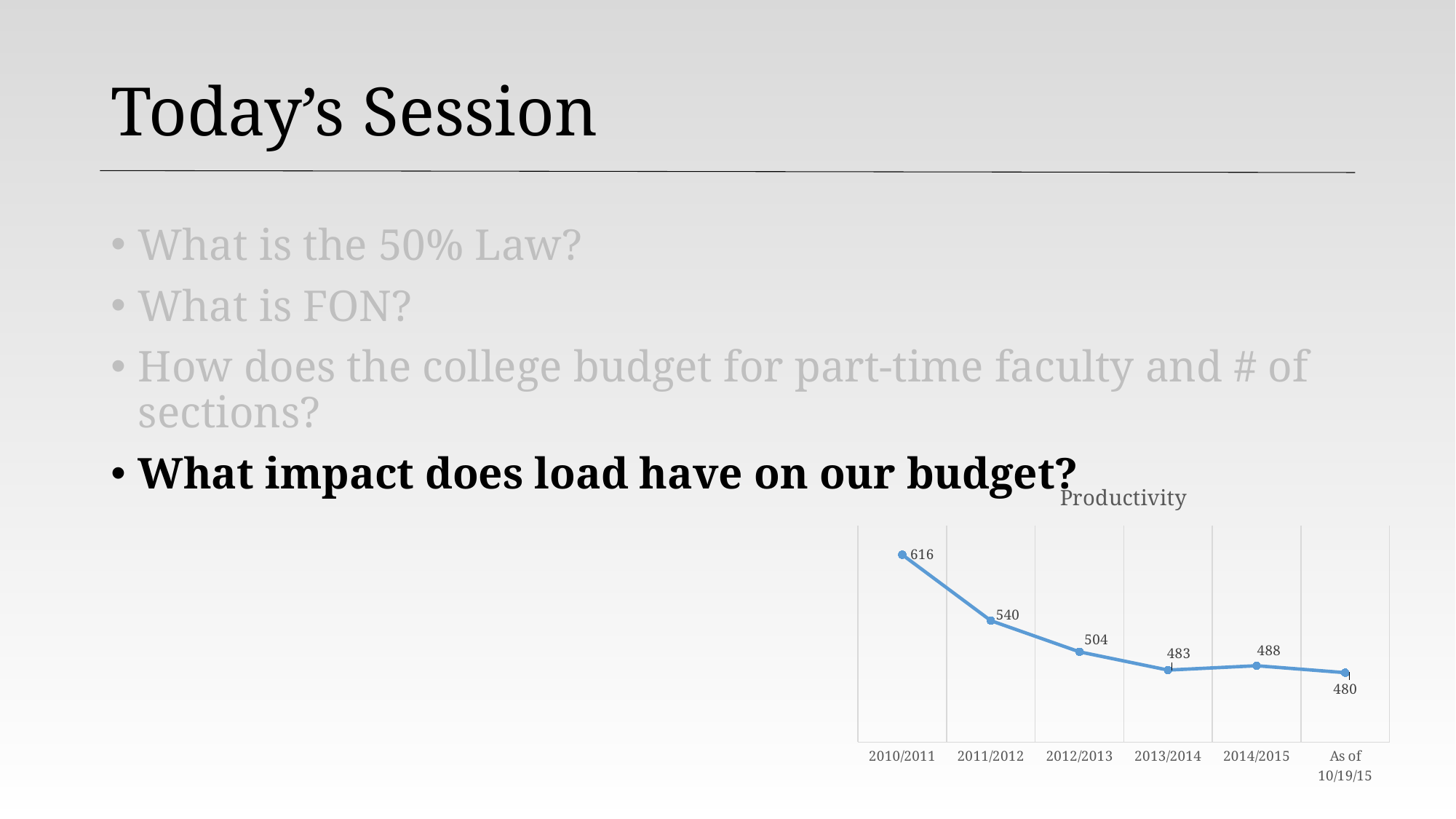
What is the Productivity value for 2010/2011? 616 How many data points are plotted in the Productivity chart? 6 What is the difference between the Productivity values for 2014/2015 and 2013/2014? 5 Does the Productivity value rise or fall from 2010/2011 to 2013/2014? fall What is the title of the chart on the slide? Productivity What is the Productivity value as of 10/19/15? 480 What kind of chart is the Productivity chart? line chart Which period has the lowest Productivity value? As of 10/19/15 Which is larger, the Productivity value for 2013/2014 or for 2014/2015? 2014/2015 What is the difference between the Productivity values for 2010/2011 and 2011/2012? 76 What is the Productivity value for 2012/2013? 504 Which period has the highest Productivity value? 2010/2011